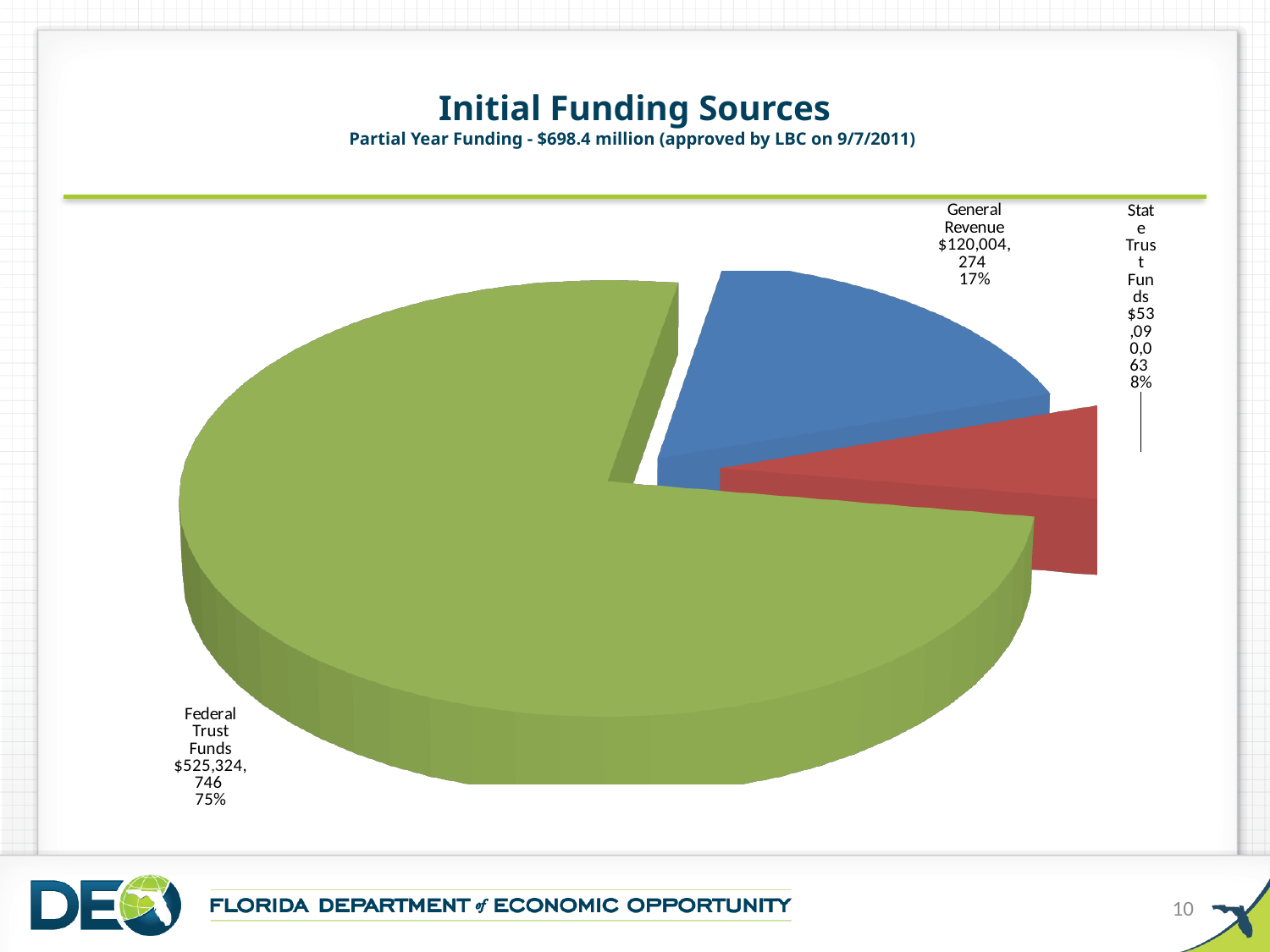
Which is larger, General Revenue or State Trust Funds? General Revenue What type of chart is shown on the slide? Pie chart What is the difference between the General Revenue and State Trust Funds values? $66,914,211 How many slices does the pie chart have? 3 What is the value for Federal Trust Funds? $525,324,746 What is the value for State Trust Funds? $53,090,063 What share of the pie does State Trust Funds represent? 8% What is the value for General Revenue? $120,004,274 Which funding source is the smallest? State Trust Funds What share of the pie does General Revenue represent? 17% What share of the pie does Federal Trust Funds represent? 75% Which funding source is the largest? Federal Trust Funds